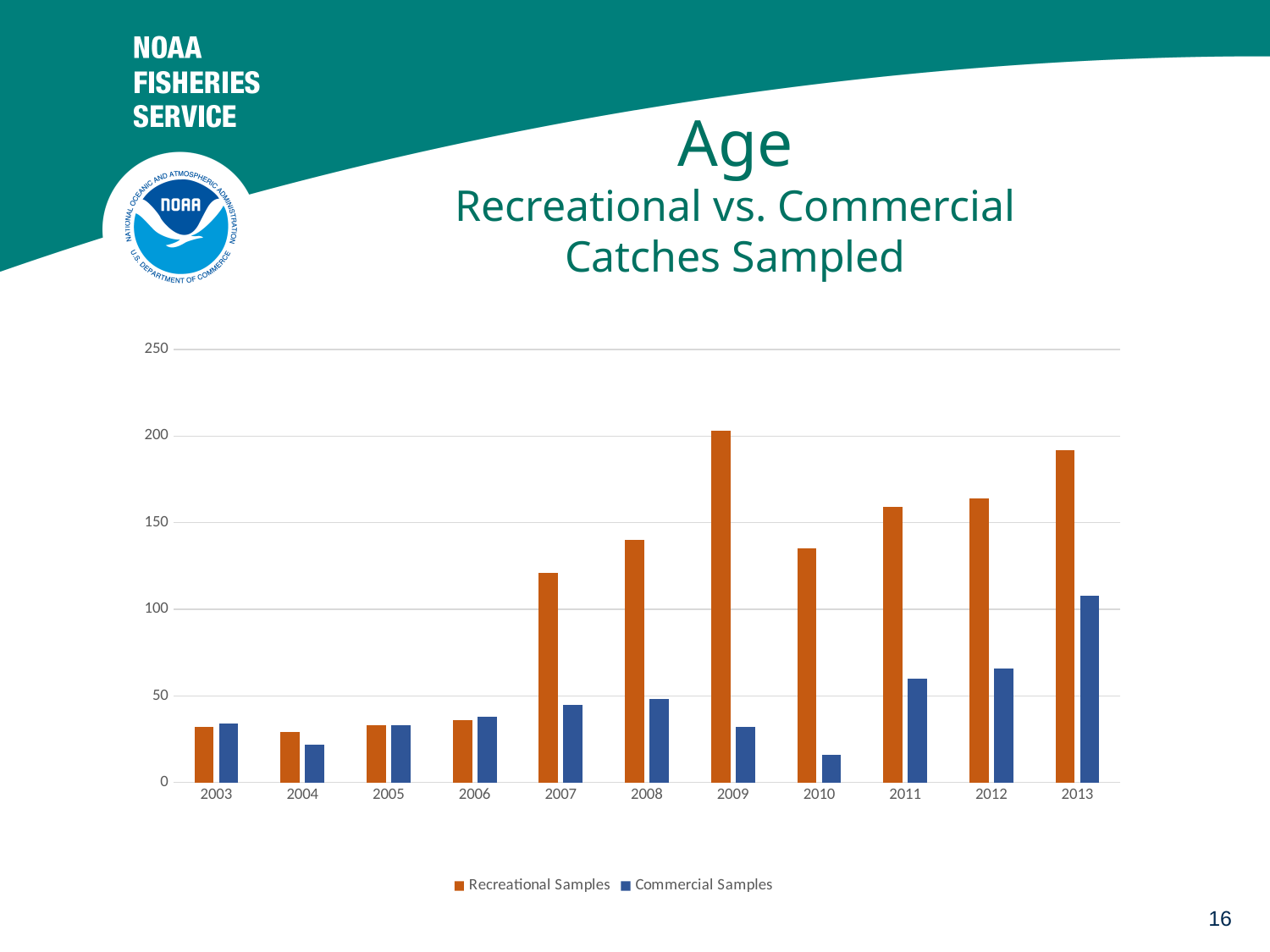
How many years are shown on the x axis? 11 Overall, do Recreational Samples rise or fall from 2003 to 2013? Rise Is the value for Commercial Samples in 2010 greater or less than 50? less Which is larger: Commercial Samples in 2011 or Commercial Samples in 2009? Commercial Samples in 2011 How many series does the legend list? 2 Is the value for Commercial Samples in 2013 greater or less than 100? greater In which year is the Commercial Samples bar lowest? 2010 In which year is the Commercial Samples bar highest? 2013 Is the value for Recreational Samples in 2009 greater or less than 150? greater In which year is the Recreational Samples bar highest? 2009 What kind of chart is shown on the slide? Bar chart In 2013, which is larger: Recreational Samples or Commercial Samples? Recreational Samples